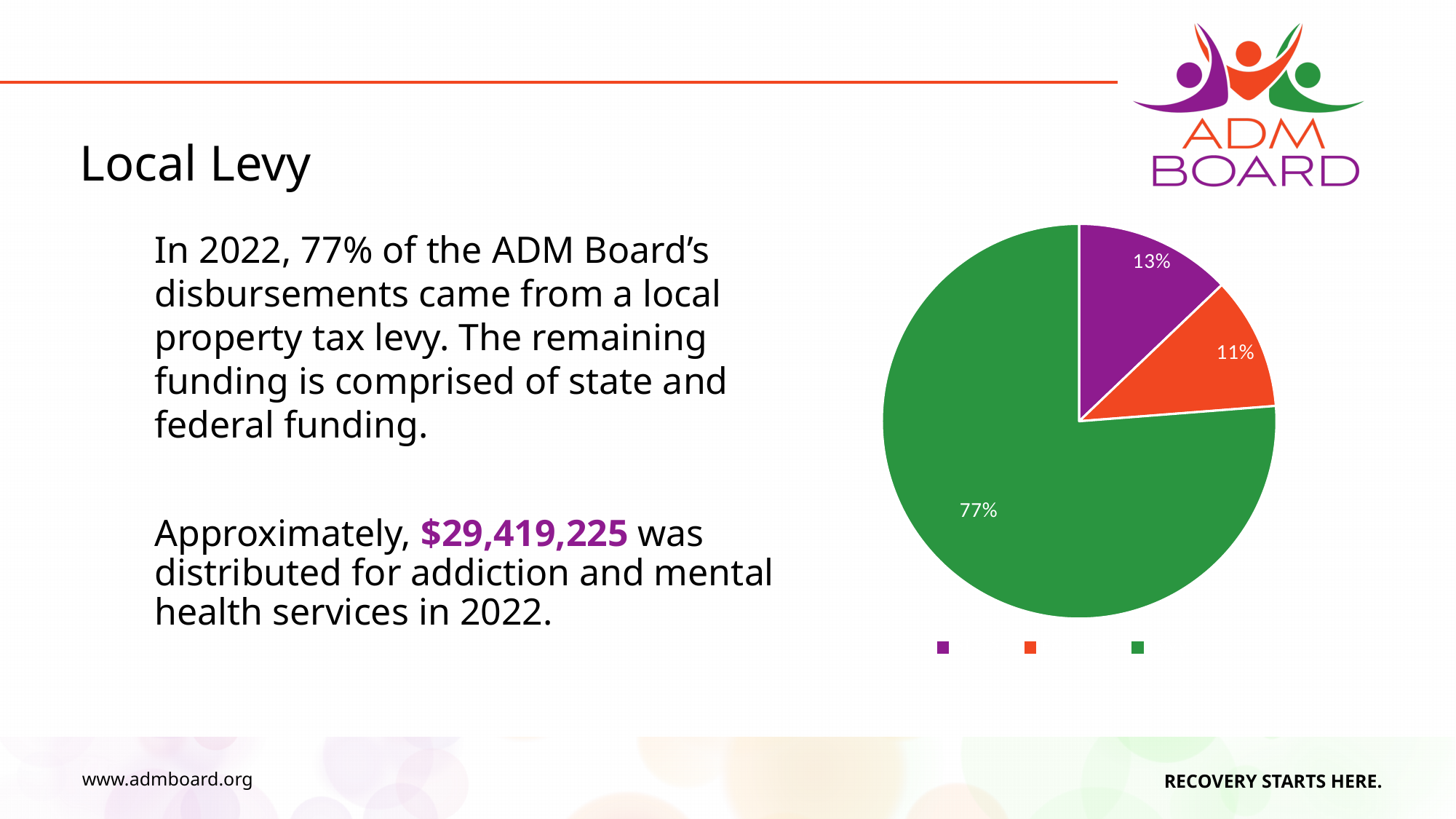
How many slices does the pie chart have? 3 Which slice of the pie chart is the largest? the green slice (77%) What percentage is shown on the purple slice of the pie chart? 13% Which is larger in the pie chart, the purple slice or the orange slice? the purple slice Which slice of the pie chart is the smallest? the orange slice (11%) What kind of chart is shown on the slide? pie chart How many entries does the legend below the pie chart show? 3 What is the difference between the green slice and the purple slice in the pie chart? 64% What colour is the slice representing the local property tax levy in the pie chart? green What percentage is shown on the green slice of the pie chart? 77% What is the combined share of the purple and orange slices in the pie chart? 24% What percentage is shown on the orange slice of the pie chart? 11%